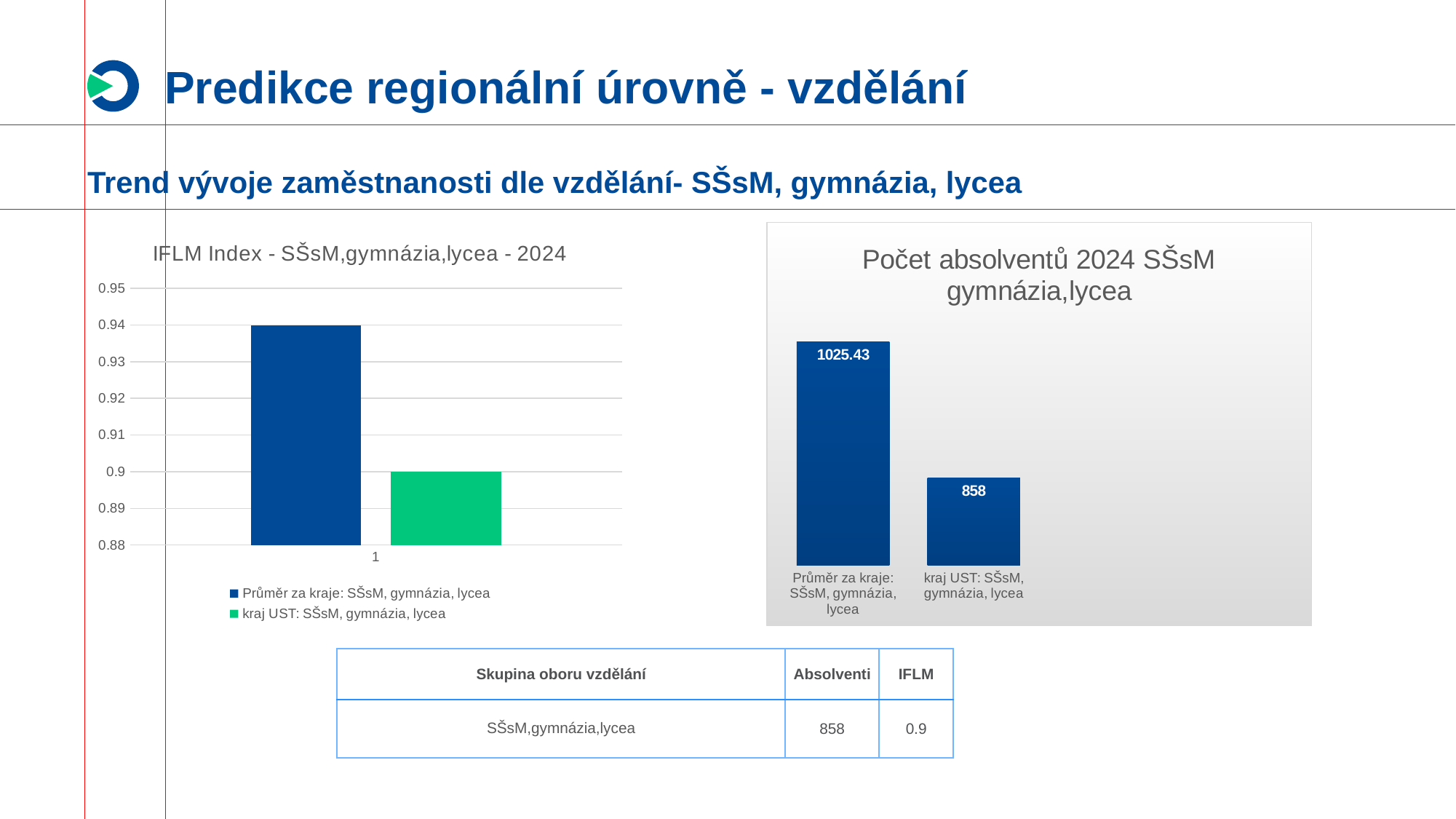
In the chart titled "Počet absolventů 2024 SŠsM gymnázia,lycea", what is the difference between the two bars? 167.43 In the chart titled "IFLM Index - SŠsM,gymnázia,lycea - 2024", how many series does the legend list? 2 What kind of chart is the chart titled "IFLM Index - SŠsM,gymnázia,lycea - 2024"? bar chart In the chart titled "IFLM Index - SŠsM,gymnázia,lycea - 2024", what is the value for "kraj UST: SŠsM, gymnázia, lycea"? 0.9 In the chart titled "Počet absolventů 2024 SŠsM gymnázia,lycea", what is the value for "kraj UST: SŠsM, gymnázia, lycea"? 858 In the chart titled "IFLM Index - SŠsM,gymnázia,lycea - 2024", what colour is the bar for "kraj UST: SŠsM, gymnázia, lycea"? green In the chart titled "IFLM Index - SŠsM,gymnázia,lycea - 2024", which series has the lower value? kraj UST: SŠsM, gymnázia, lycea In the chart titled "Počet absolventů 2024 SŠsM gymnázia,lycea", which category has the highest value? Průměr za kraje: SŠsM, gymnázia, lycea In the chart titled "IFLM Index - SŠsM,gymnázia,lycea - 2024", is the value for "Průměr za kraje: SŠsM, gymnázia, lycea" greater or less than 0.92? greater In the chart titled "Počet absolventů 2024 SŠsM gymnázia,lycea", what is the value for "Průměr za kraje: SŠsM, gymnázia, lycea"? 1025.43 In the chart titled "Počet absolventů 2024 SŠsM gymnázia,lycea", how many bars are plotted? 2 In the chart titled "IFLM Index - SŠsM,gymnázia,lycea - 2024", what is the value for "Průměr za kraje: SŠsM, gymnázia, lycea"? 0.94